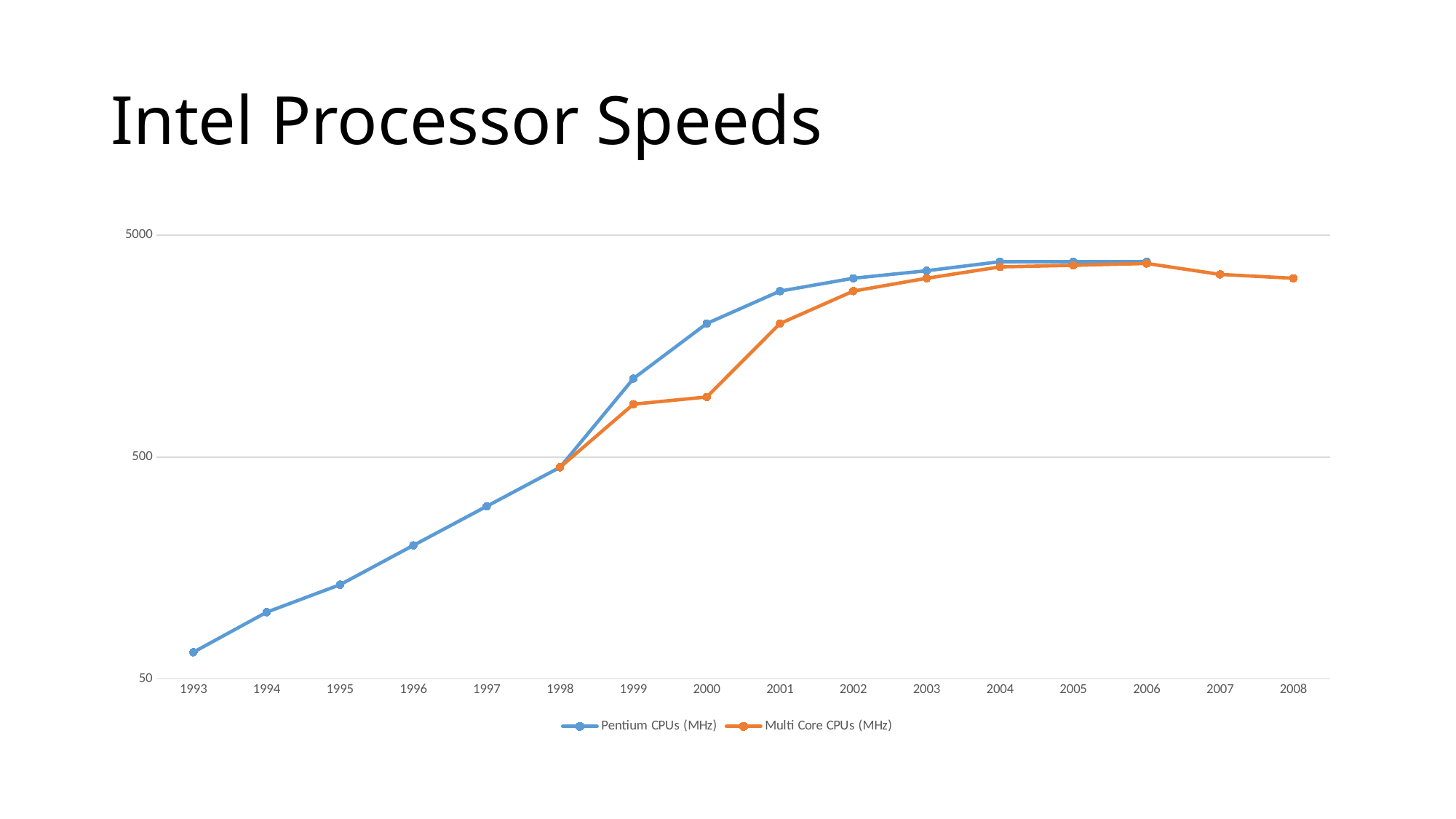
Is the value for Pentium CPUs (MHz) in 1993 greater or less than 500? less What is the title of the slide? Intel Processor Speeds In which year is the Pentium CPUs (MHz) value lowest? 1993 In 2000, which series has the larger value, Pentium CPUs (MHz) or Multi Core CPUs (MHz)? Pentium CPUs (MHz) Is the value for Pentium CPUs (MHz) in 2000 greater or less than 500? greater How many series does the legend list? 2 Do the Pentium CPUs (MHz) values rise or fall from 1993 to 2004? rise What kind of chart is shown on the slide? line chart Is the value for Multi Core CPUs (MHz) in 1999 greater or less than 500? greater How many years are shown along the x axis? 16 In which year is the Multi Core CPUs (MHz) value lowest? 1998